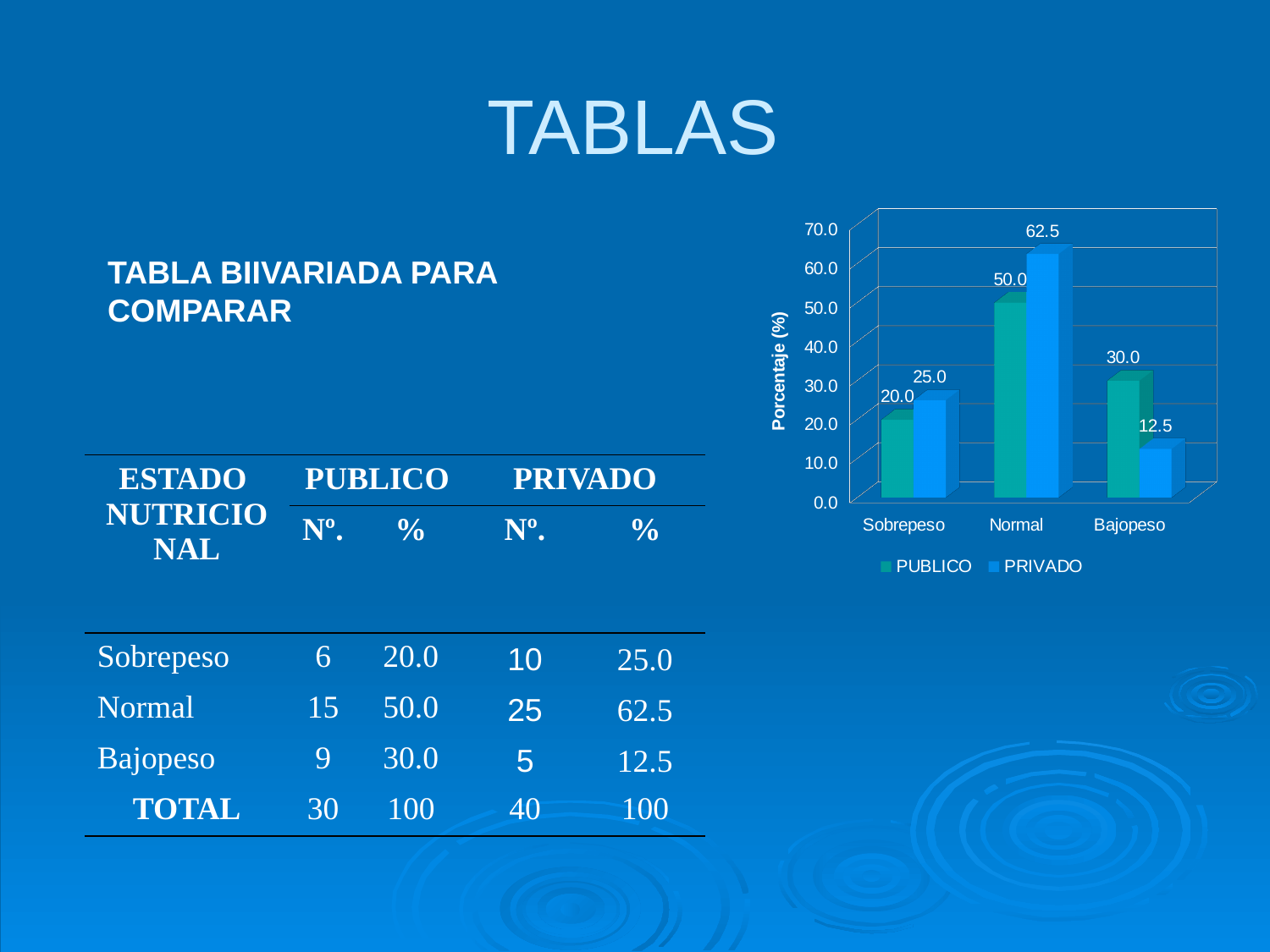
What is the PUBLICO value for Sobrepeso in the chart? 20.0 What is the difference between the PRIVADO and PUBLICO values for Normal in the chart? 12.5 What kind of chart is shown on the slide? bar chart Is the PUBLICO value for Normal greater or less than 40.0 in the chart? greater What is the PRIVADO value for Normal in the chart? 62.5 Which category has the highest PRIVADO value in the chart? Normal What is the PRIVADO value for Bajopeso in the chart? 12.5 For Bajopeso, which series has the larger value in the chart, PUBLICO or PRIVADO? PUBLICO Which category has the lowest PUBLICO value in the chart? Sobrepeso How many series does the chart legend list? 2 How many categories are shown on the x axis of the chart? 3 What is the label of the vertical axis of the chart? Porcentaje (%)